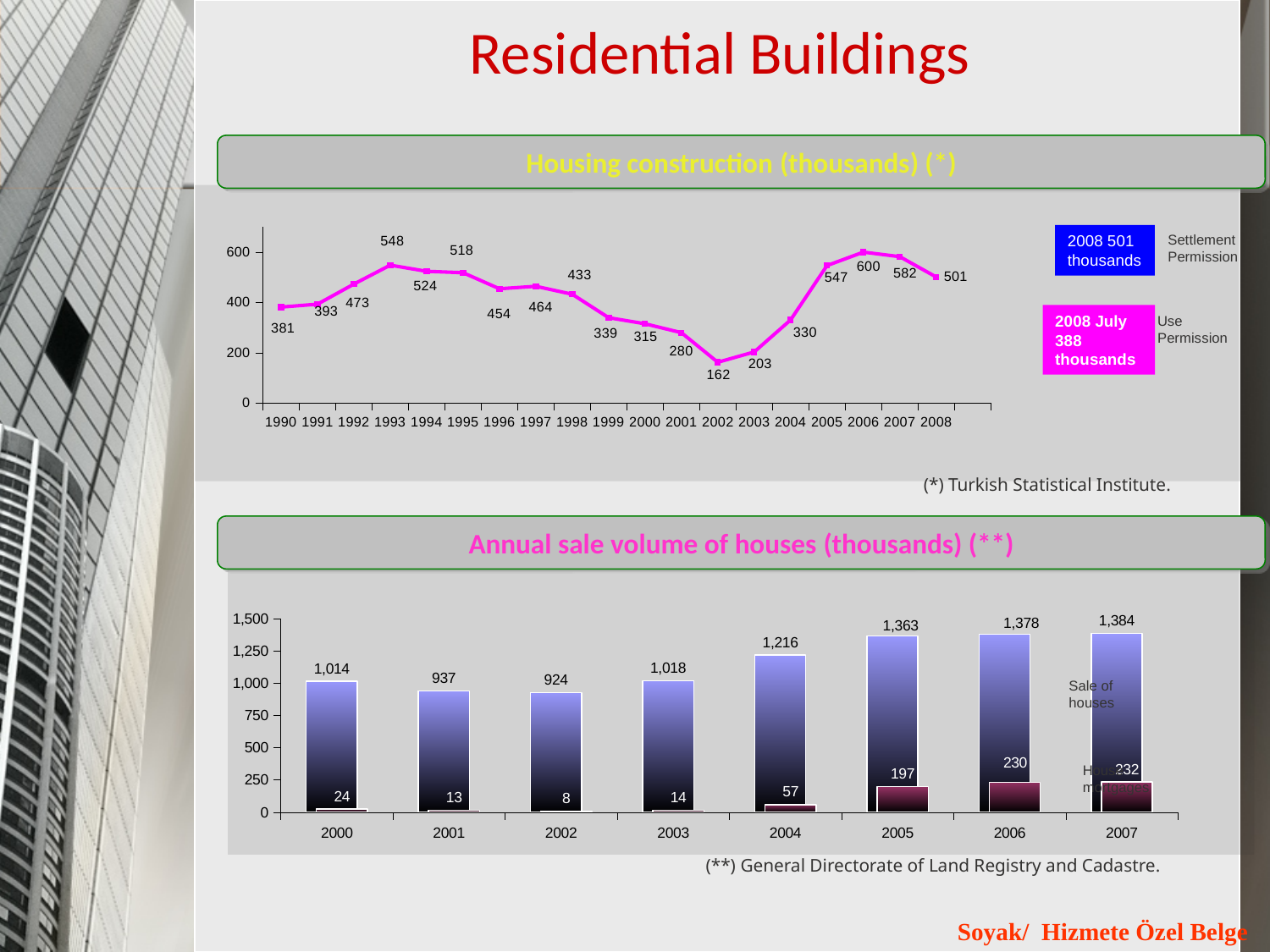
In the Annual sale volume of houses chart, is the Sale of houses value for 2001 larger or smaller than the value for 2003? Smaller In the Housing construction chart, what is the value for 2002? 162 In the Housing construction chart, do the values rise or fall from 2002 to 2006? Rise In the Housing construction chart, what is the difference between the values for 2006 and 2008? 99 What kind of chart is the Annual sale volume of houses chart? Bar chart In the Annual sale volume of houses chart, which year has the lowest Sale of houses value? 2002 In the Annual sale volume of houses chart, what is the difference between the House mortgages values for 2006 and 2005? 33 In the Housing construction chart, which year has the highest value? 2006 In the Housing construction chart, how many years are plotted on the x axis? 19 In the Annual sale volume of houses chart, what is the Sale of houses value for 2004? 1,216 What kind of chart is the Housing construction chart? Line chart In the Housing construction chart, which year has the lowest value? 2002